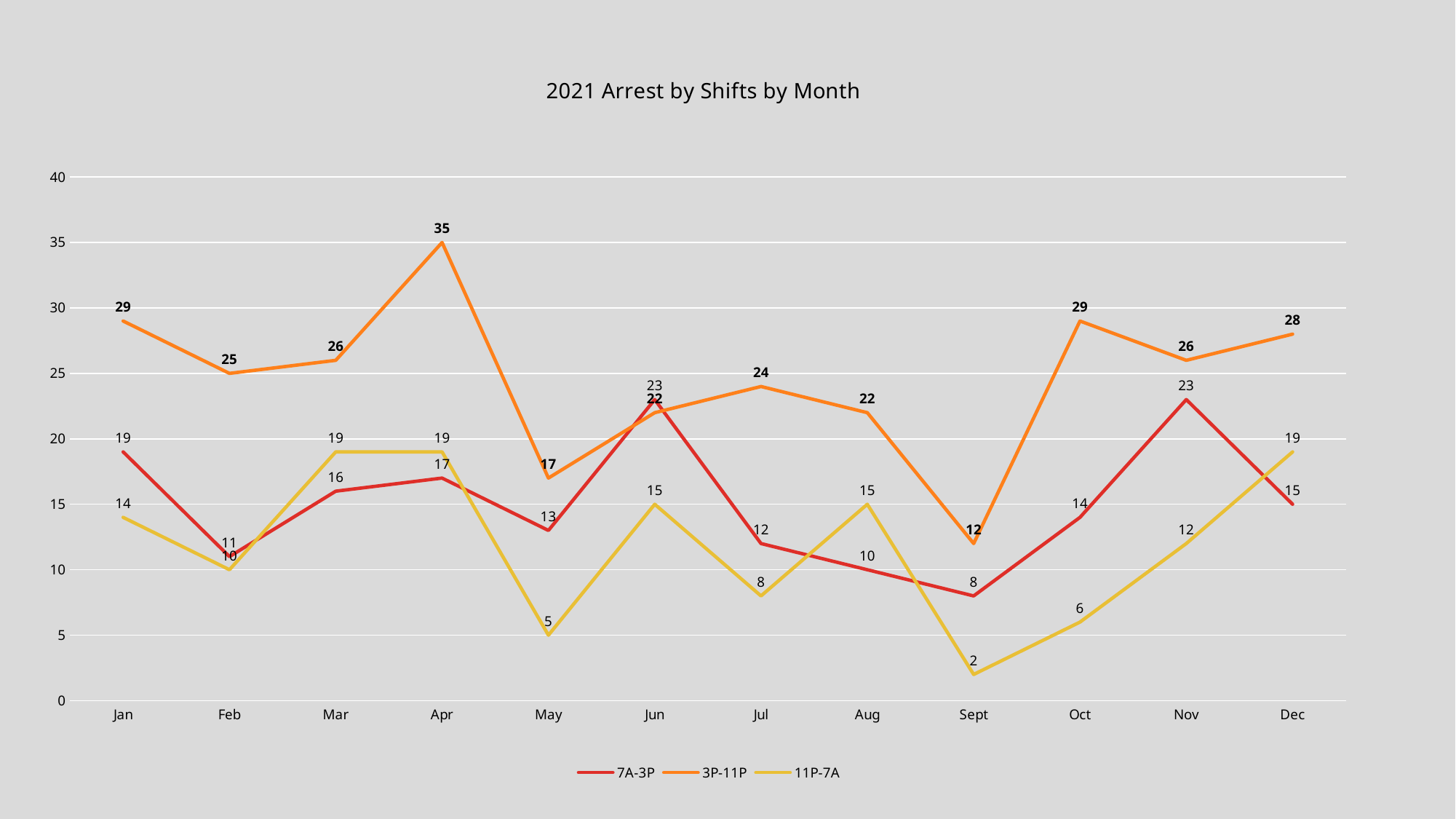
What is the value for the 11P-7A shift in September? 2 In which month is the 7A-3P shift at its lowest? Sept In which month is the 3P-11P shift at its highest? Apr What is the value for the 7A-3P shift in November? 23 Which shift has the larger value in December, 7A-3P or 11P-7A? 11P-7A Does the 11P-7A shift rise or fall from September to December? rise How many months are plotted along the x axis? 12 What is the value for the 3P-11P shift in April? 35 What type of chart is shown on the slide? line chart What is the title of the chart? 2021 Arrest by Shifts by Month How many series does the legend list? 3 What is the difference between the 3P-11P and 7A-3P values in April? 18